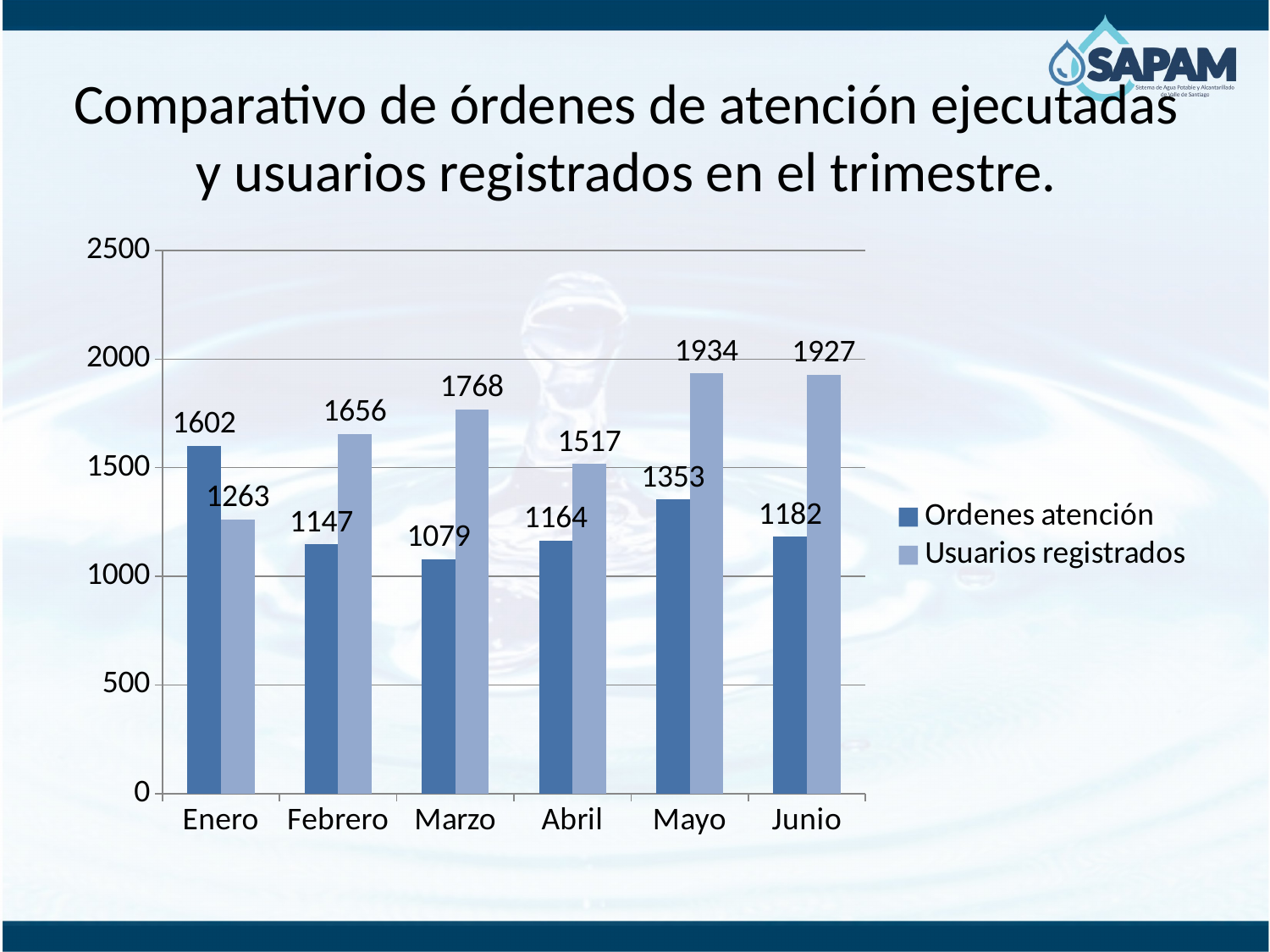
Is the value of Usuarios registrados for Abril greater or less than 1500? greater What kind of chart is shown on the slide? Bar chart What is the value of Usuarios registrados for Marzo? 1768 Does the value of Ordenes atención rise or fall from Enero to Marzo? Fall What is the value of Ordenes atención for Mayo? 1353 What is the value of Ordenes atención for Enero? 1602 Which month has the highest value for Usuarios registrados? Mayo How many series does the legend list? 2 Which month has the lowest value for Ordenes atención? Marzo Which is larger in Enero: Ordenes atención or Usuarios registrados? Ordenes atención What is the difference between Usuarios registrados and Ordenes atención in Junio? 745 How many months are shown on the x axis? 6